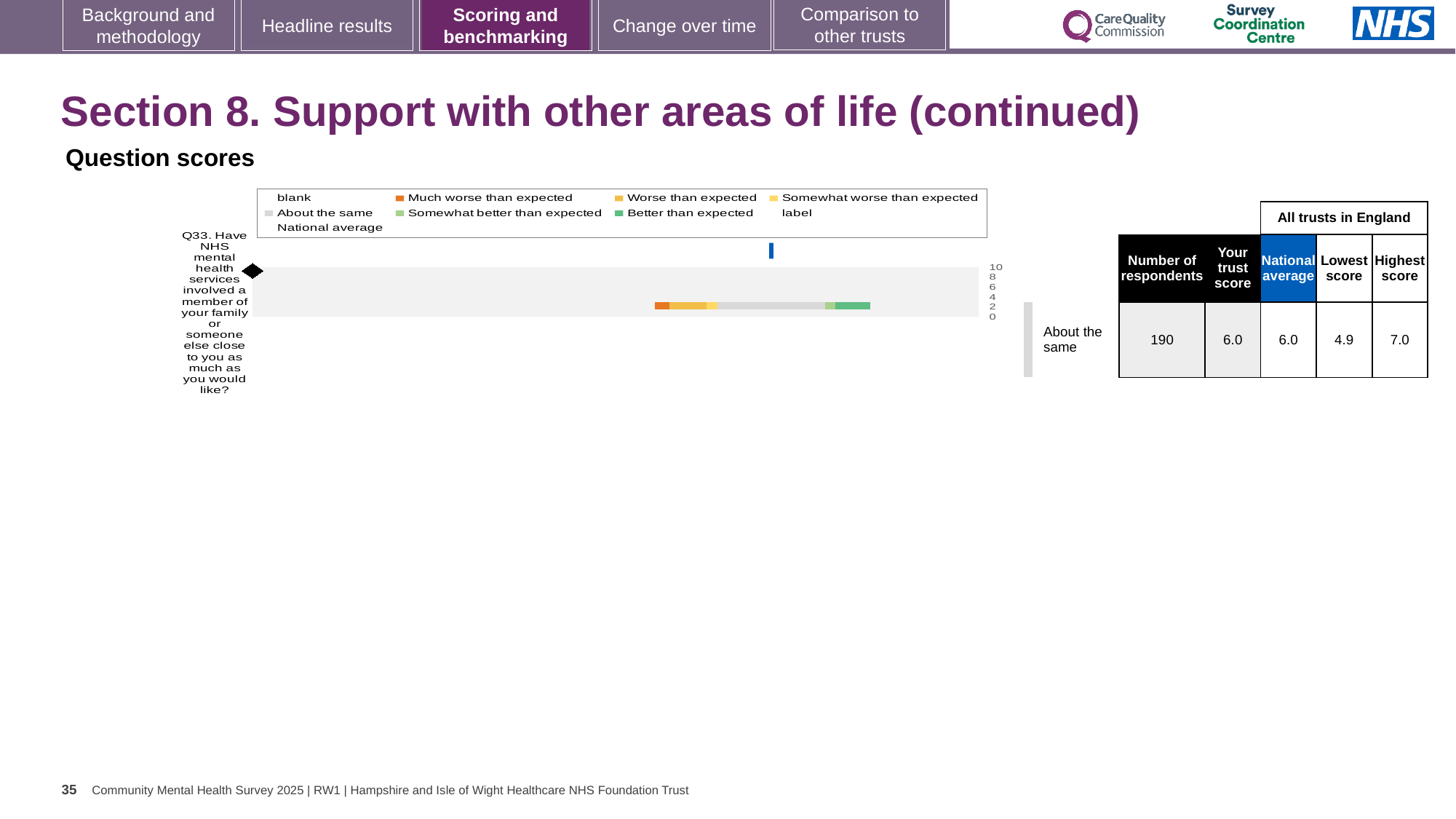
How is the trust's score for Q33 categorised compared with what is expected? About the same What is the trust score for Q33 shown in the table next to the chart? 6.0 How many survey questions are plotted in the question scores chart? 1 What is the lowest score among all trusts in England for Q33? 4.9 How many entries does the legend of the question scores chart list? 9 Which question is plotted in the question scores chart? Q33. Have NHS mental health services involved a member of your family or someone else close to you as much as you would like? What is the national average score for Q33? 6.0 What is the highest score among all trusts in England for Q33? 7.0 What is the difference between the highest and lowest scores for Q33 across all trusts in England? 2.1 Is the trust score for Q33 greater or less than 4 on the chart's axis? greater What kind of chart is used to show the question scores on this slide? bar chart How many respondents answered Q33? 190